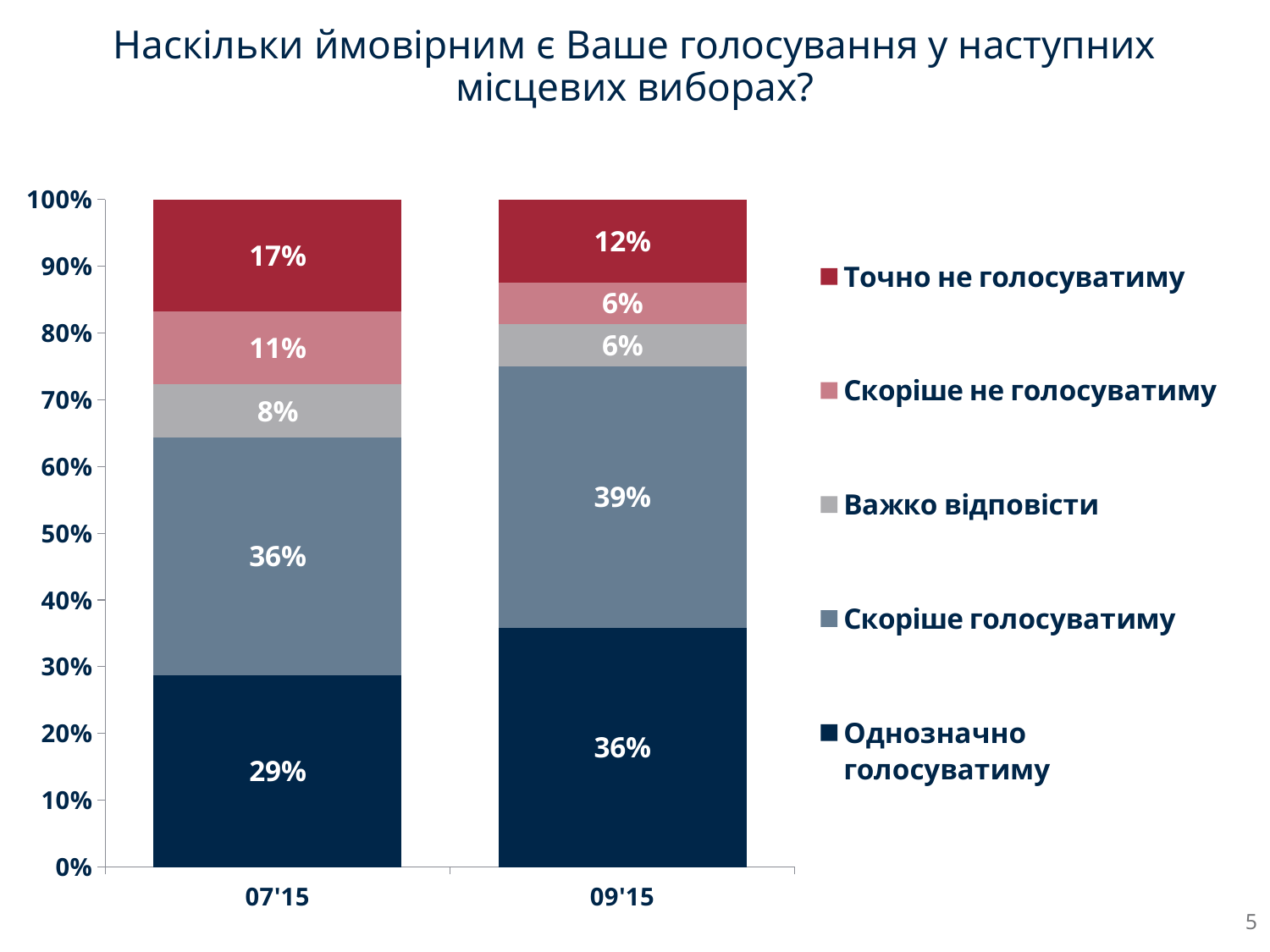
What is the value for "Однозначно голосуватиму" in 07'15? 29% What is the difference between the "Точно не голосуватиму" values for 07'15 and 09'15? 5% What is the difference between the "Скоріше не голосуватиму" values for 07'15 and 09'15? 5% How many series does the legend list? 5 What is the value for "Точно не голосуватиму" in 07'15? 17% What is the value for "Важко відповісти" in 09'15? 6% Which period has the higher value for "Однозначно голосуватиму", 07'15 or 09'15? 09'15 How many periods are shown on the x axis? 2 Which series has the smallest value in the 07'15 bar? Важко відповісти What is the value for "Скоріше голосуватиму" in 09'15? 39% Which series has the largest value in the 07'15 bar? Скоріше голосуватиму What kind of chart is shown on the slide? Stacked bar chart